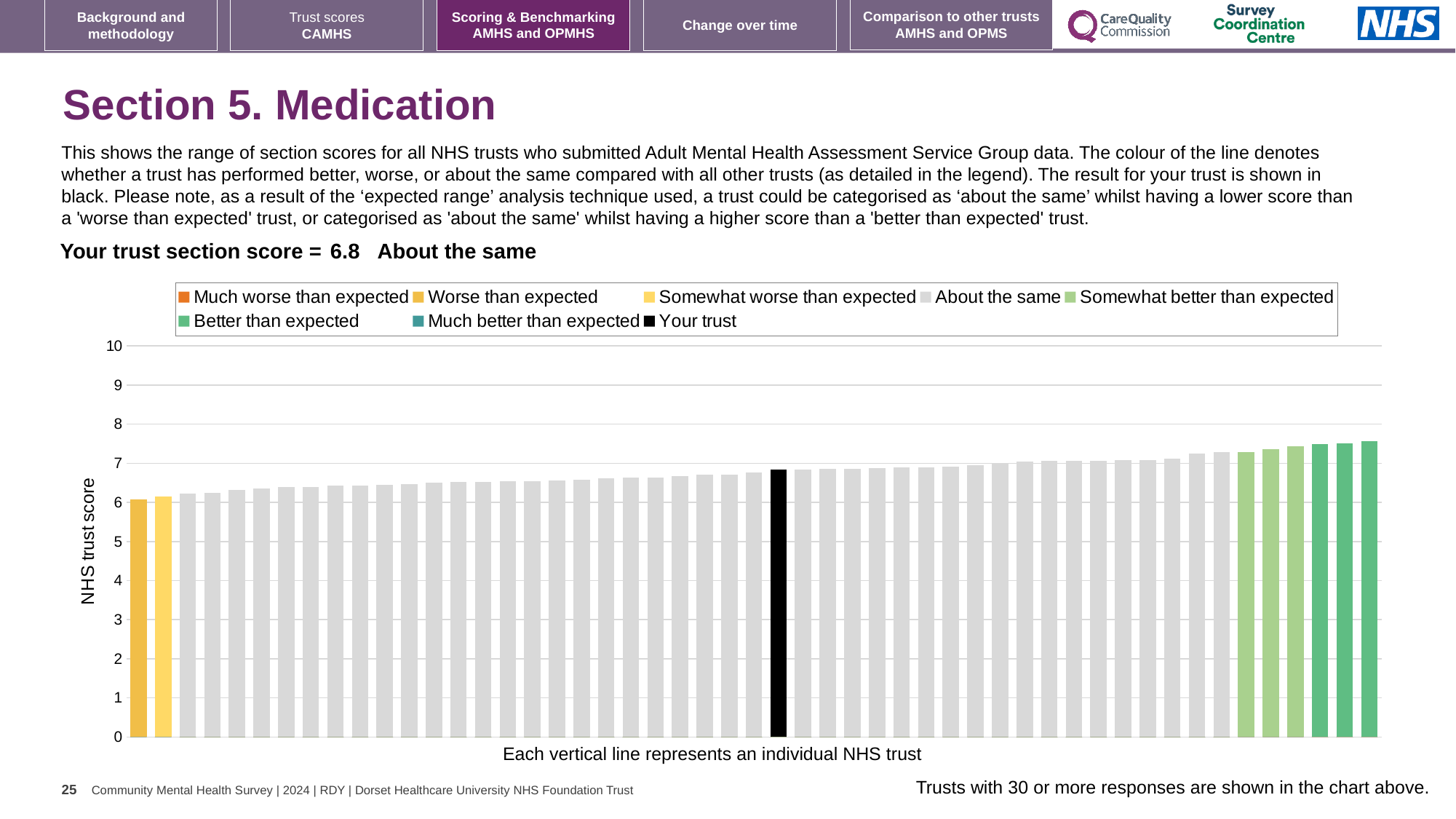
How many entries does the chart legend list? 8 What is the highest value shown on the vertical axis? 10 Is the value for your trust (the black bar) greater or less than 5? greater What is the label on the vertical axis of the chart? NHS trust score What colour is the bar representing your trust? black Which legend category does the shortest bar on the far left belong to? Worse than expected Do the bar values rise or fall from left to right along the x axis? rise What is the section score for your trust shown on the slide? 6.8 Which legend category do the tallest bars on the right of the chart belong to? Better than expected Is the value of the tallest bar greater or less than 7? greater Is the value of the shortest bar greater or less than 7? less What kind of chart is shown on the slide? bar chart